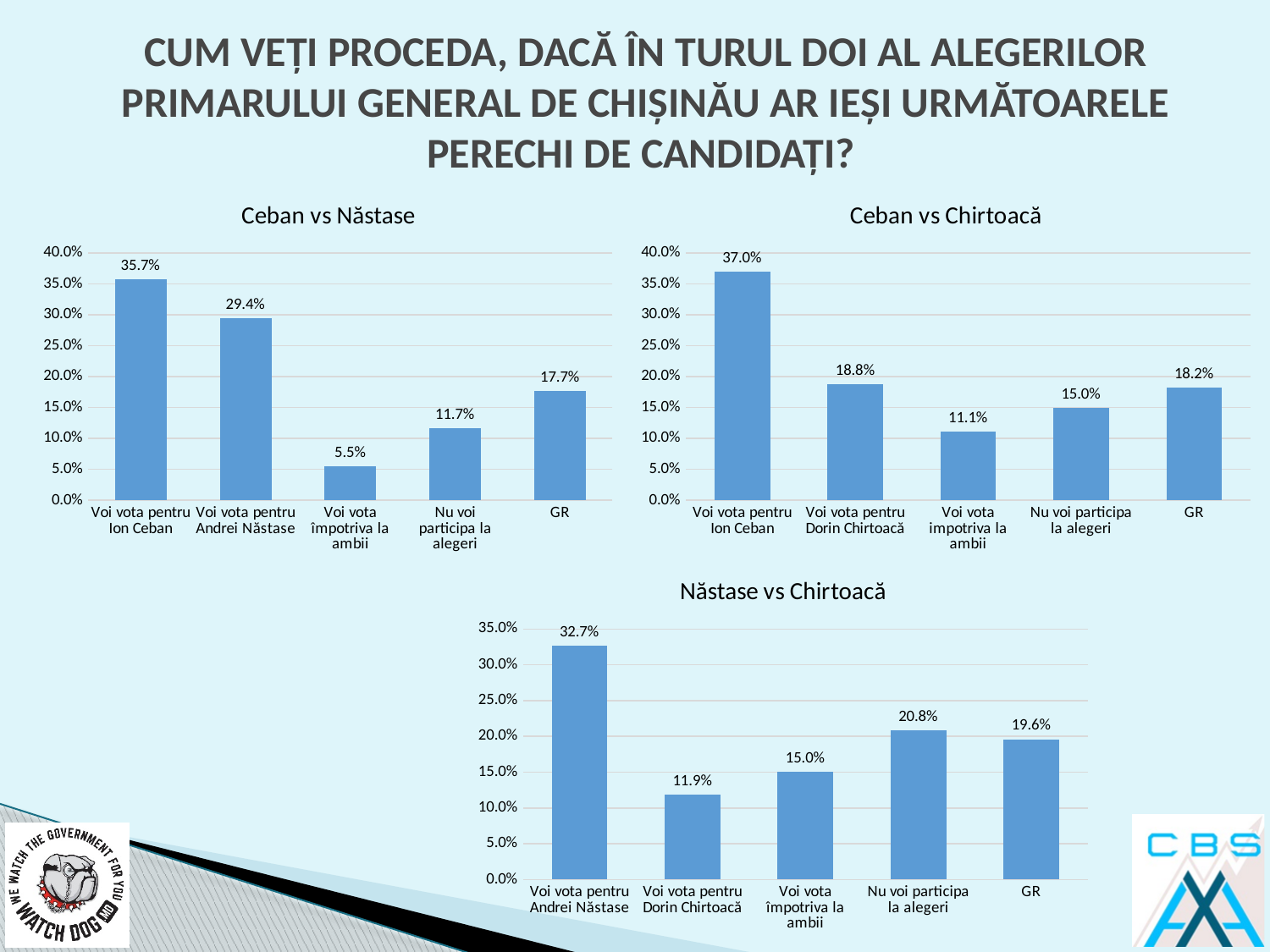
In the 'Ceban vs Chirtoacă' chart, which is larger: 'Nu voi participa la alegeri' or 'GR'? GR In the 'Năstase vs Chirtoacă' chart, which category has the lowest value? Voi vota pentru Dorin Chirtoacă In the 'Ceban vs Năstase' chart, which category has the lowest value? Voi vota împotriva la ambii In the 'Ceban vs Năstase' chart, what is the value for 'Voi vota pentru Ion Ceban'? 35.7% In the 'Ceban vs Năstase' chart, what is the difference between 'Voi vota pentru Ion Ceban' and 'Voi vota pentru Andrei Năstase'? 6.3% In the 'Ceban vs Chirtoacă' chart, which category has the highest value? Voi vota pentru Ion Ceban How many charts are shown on the slide? 3 In the 'Ceban vs Chirtoacă' chart, what is the value for 'Voi vota pentru Dorin Chirtoacă'? 18.8% How many categories are shown in the 'Năstase vs Chirtoacă' chart? 5 In the 'Năstase vs Chirtoacă' chart, what is the value for 'Nu voi participa la alegeri'? 20.8% What kind of chart is the 'Ceban vs Năstase' chart? Bar chart In the 'Năstase vs Chirtoacă' chart, what is the difference between 'Voi vota pentru Andrei Năstase' and 'Voi vota pentru Dorin Chirtoacă'? 20.8%